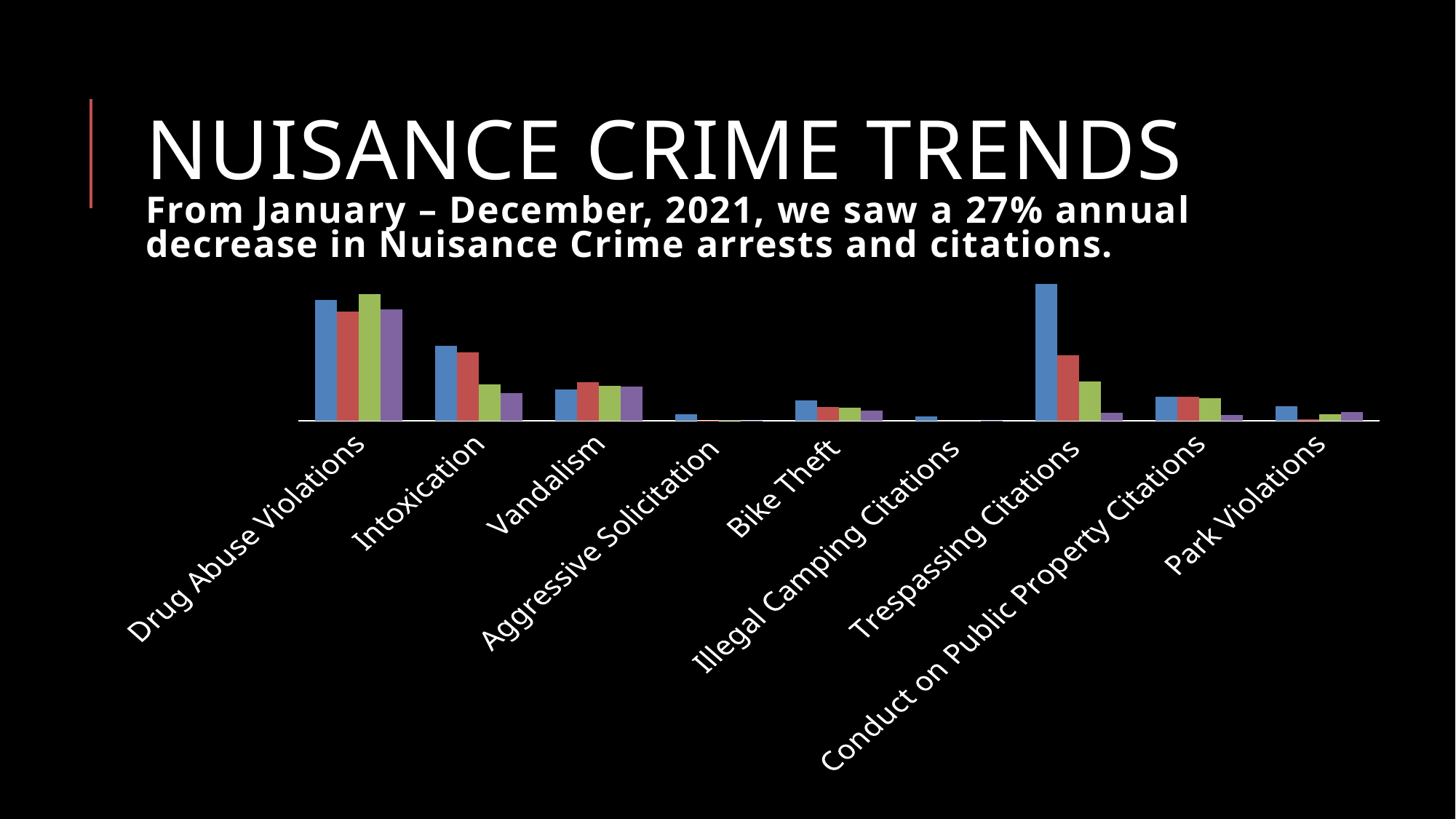
What is the title of the slide containing the chart? Nuisance Crime Trends Which category contains the tallest bar in the chart? Trespassing Citations Within the Trespassing Citations category, which is larger: the blue bar or the red bar? the blue bar Which is larger: the blue bar for Vandalism or the blue bar for Bike Theft? Vandalism How many bars are plotted for each category in the chart? 4 Within the Intoxication category, do the bars rise or fall from left to right? fall What kind of chart is shown on the slide? bar chart Which is larger: the blue bar for Drug Abuse Violations or the blue bar for Intoxication? Drug Abuse Violations Within the Trespassing Citations category, do the bars rise or fall from left to right? fall Which category is plotted first (leftmost) on the x axis? Drug Abuse Violations How many categories are shown along the x axis of the chart? 9